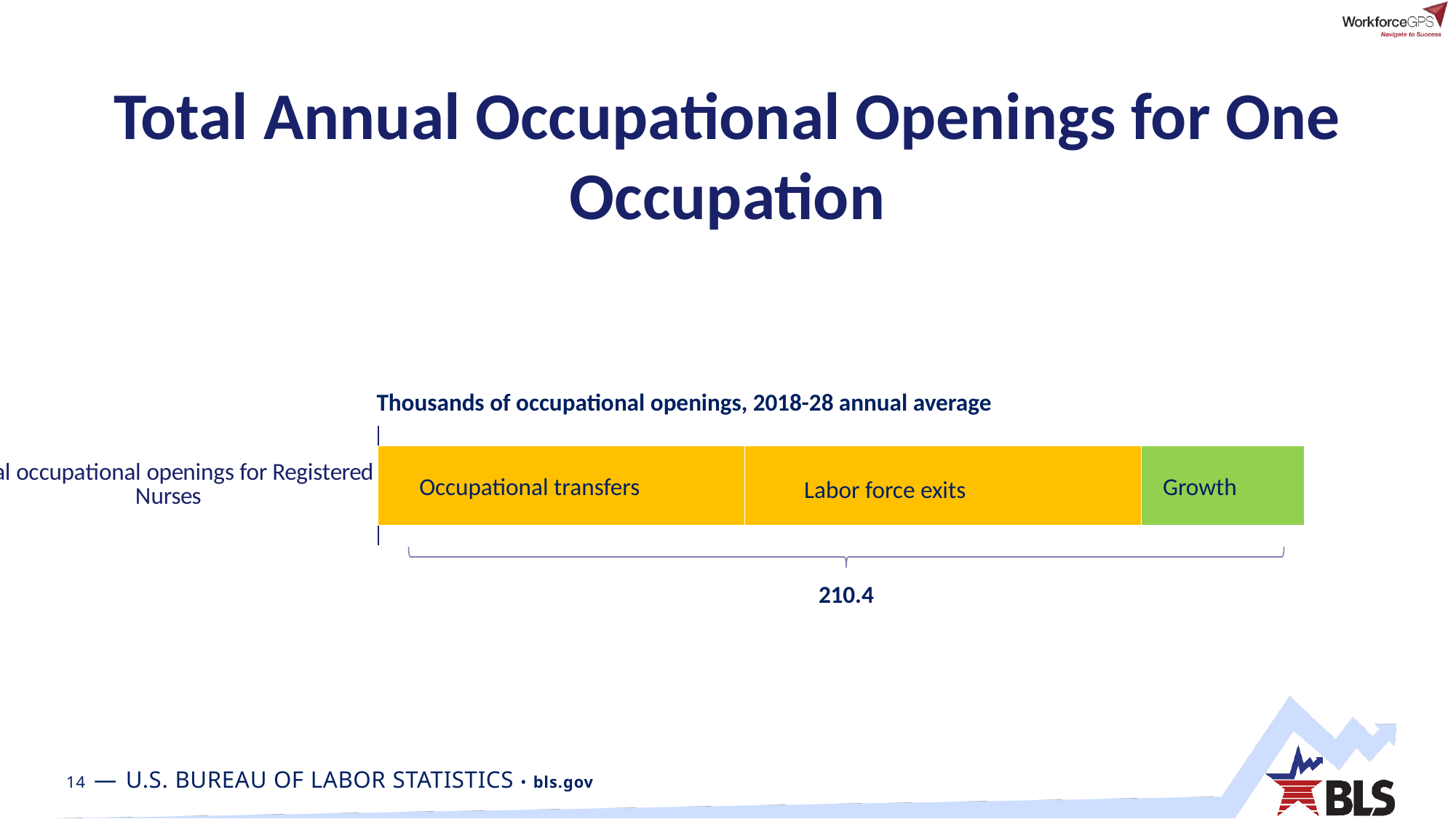
Which is larger, the Labor force exits segment or the Growth segment? Labor force exits Which segment of the bar is the smallest? Growth What is the total annual occupational openings value shown under the bar? 210.4 What kind of chart is shown on the slide? bar chart How many segments make up the stacked bar? 3 What colour is the Growth segment of the bar? green How many bars are plotted in the chart? 1 Which occupation does the bar represent? Registered Nurses What unit and period does the chart subtitle give for the values? Thousands of occupational openings, 2018-28 annual average Which is larger, the Occupational transfers segment or the Growth segment? Occupational transfers